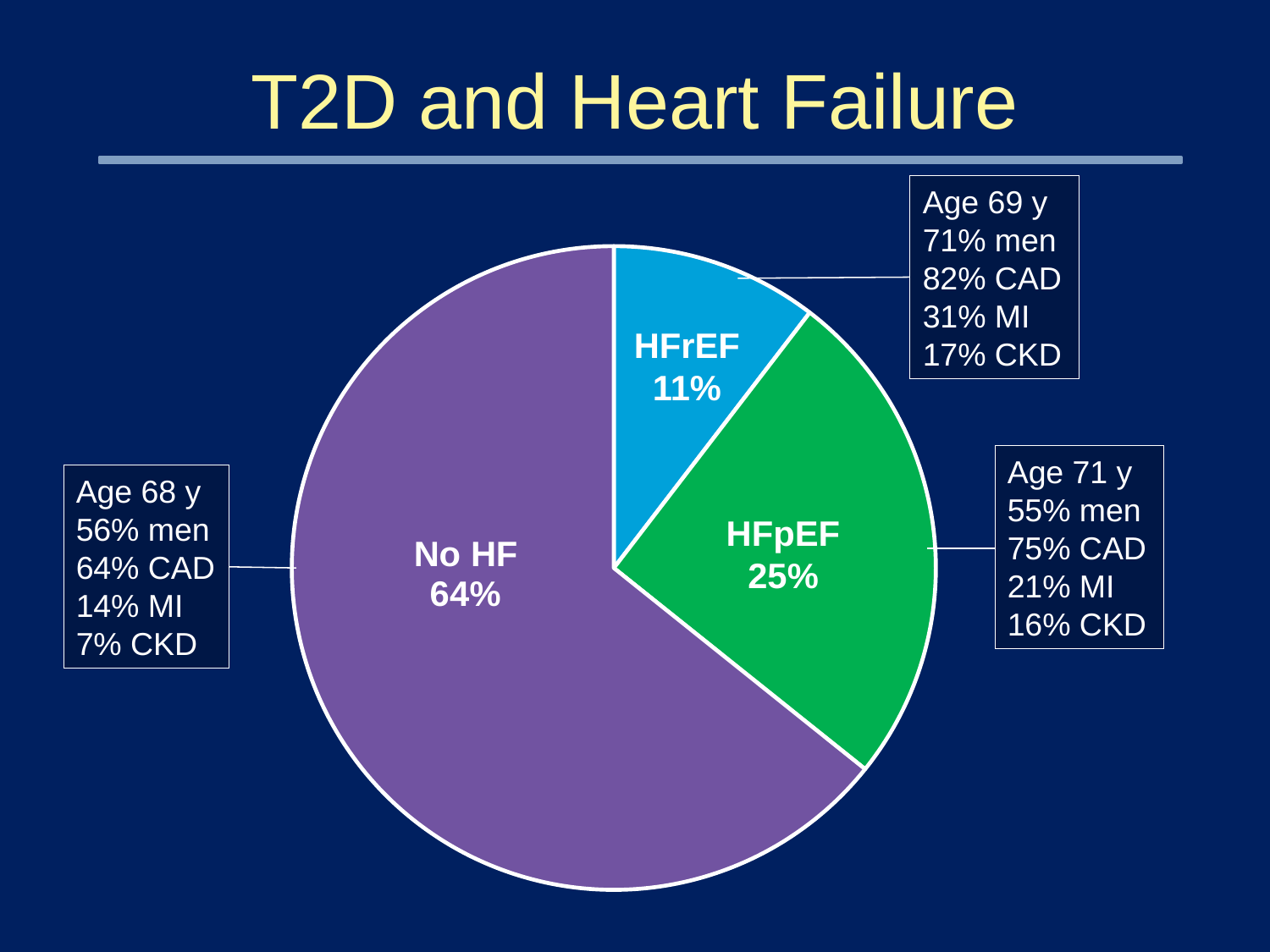
What colour is the HFpEF slice of the pie chart? green What is the title of the slide containing the pie chart? T2D and Heart Failure How many slices does the pie chart have? 3 Which slice of the pie is the smallest? HFrEF What is the difference in percentage points between the HFpEF slice and the HFrEF slice? 14 Which slice of the pie is the largest? No HF What share of the pie does the No HF slice represent? 64% What share of the pie does the HFrEF slice represent? 11% What kind of chart is shown on the slide? pie chart What is the difference in percentage points between the No HF slice and the HFpEF slice? 39 What share of the pie does the HFpEF slice represent? 25% Which is larger, the HFpEF slice or the HFrEF slice? HFpEF